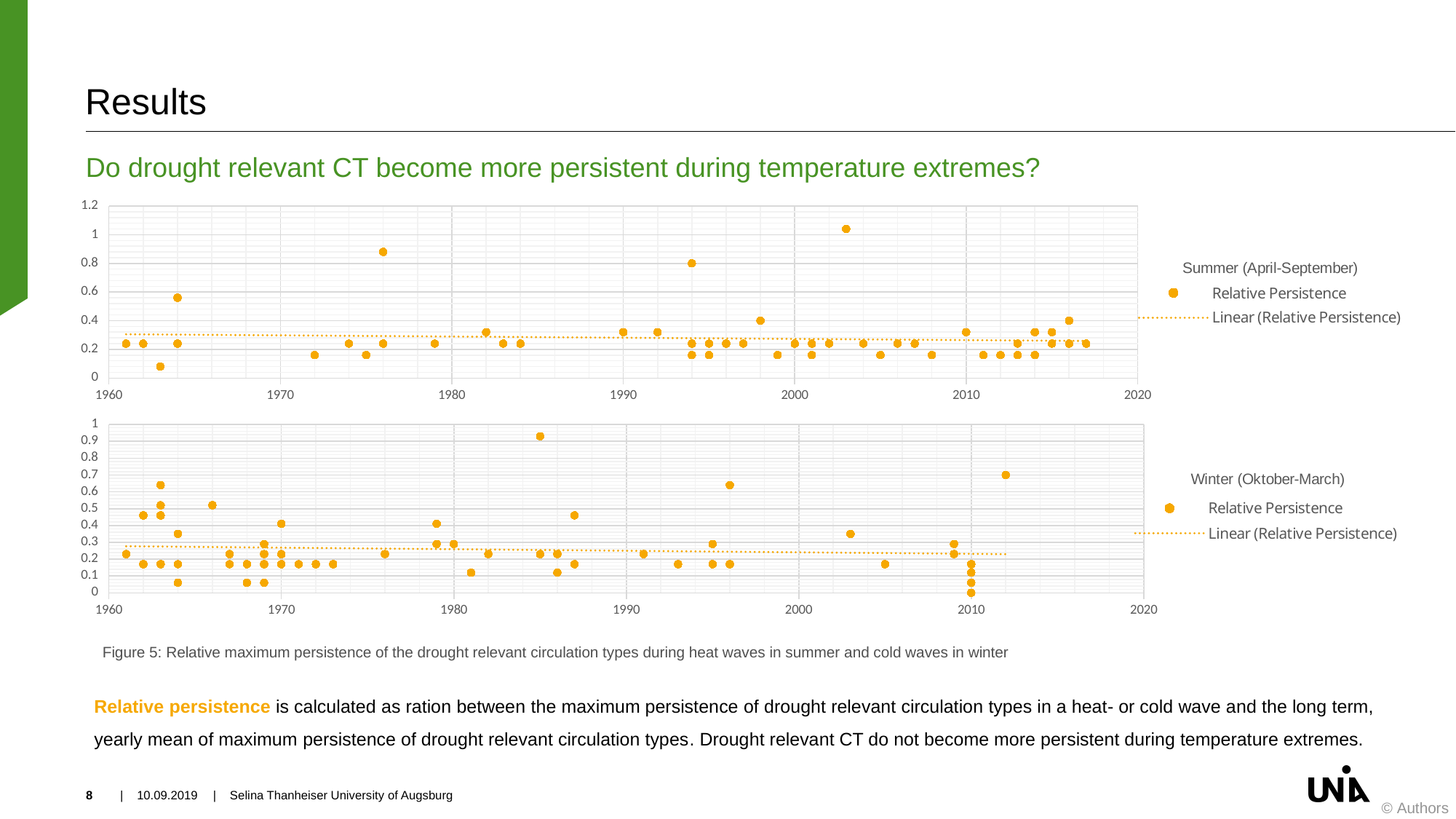
In the Summer (April-September) chart, is the point plotted at 1963 near the bottom greater or less than 0.2? less How many charts are shown on the slide? 2 In the Winter (Oktober-March) chart, is the highest plotted point greater or less than 0.8? greater How many entries does the legend of the Winter (Oktober-March) chart list? 2 In the Winter (Oktober-March) chart, does the Linear (Relative Persistence) trend line rise or fall from 1960 to 2010? fall In the Summer (April-September) chart, is the highest plotted point greater or less than 0.8? greater What is the highest value shown on the y axis of the Summer (April-September) chart? 1.2 What is the first year label on the x axis of the Winter (Oktober-March) chart? 1960 What kind of chart is the Summer (April-September) chart? scatter chart In the Summer (April-September) chart, what are the two legend entries? Relative Persistence; Linear (Relative Persistence)